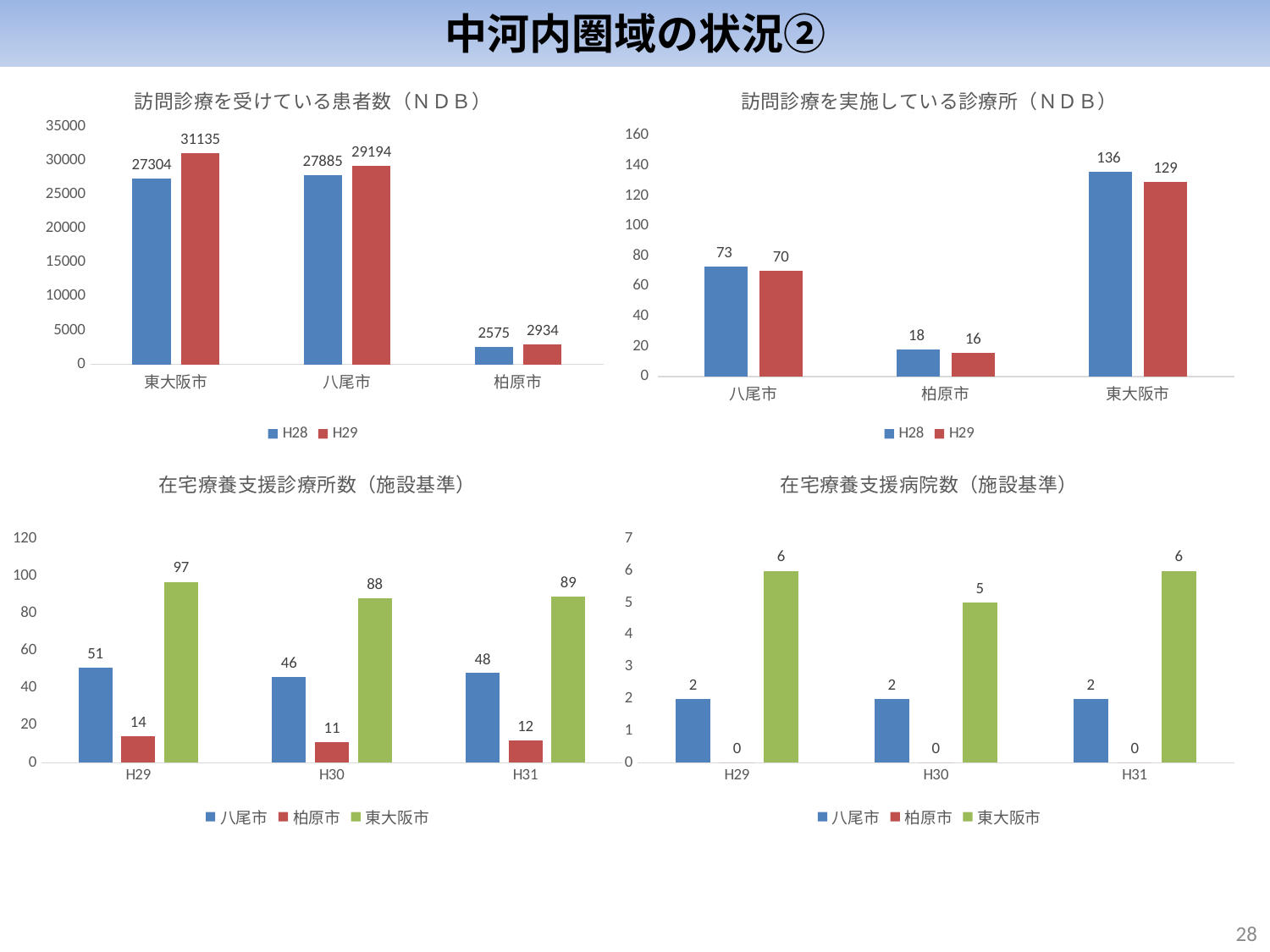
In the chart titled 訪問診療を受けている患者数（ＮＤＢ）, which category has the lowest H28 value? 柏原市 In the chart titled 訪問診療を受けている患者数（ＮＤＢ）, what is the difference between the H29 and H28 values for 八尾市? 1309 In the chart titled 在宅療養支援診療所数（施設基準）, what is the difference between 東大阪市 and 八尾市 in H29? 46 In the chart titled 在宅療養支援病院数（施設基準）, what is the value for 柏原市 in H31? 0 In the chart titled 訪問診療を実施している診療所（ＮＤＢ）, what is the H28 value for 東大阪市? 136 In the chart titled 在宅療養支援診療所数（施設基準）, what is the value for 東大阪市 in H30? 88 In the chart titled 在宅療養支援病院数（施設基準）, which series has the highest value in H30? 東大阪市 What kind of chart is the one titled 在宅療養支援病院数（施設基準）? bar chart In the chart titled 訪問診療を実施している診療所（ＮＤＢ）, which is larger for 八尾市, the H28 value or the H29 value? H28 In the chart titled 在宅療養支援診療所数（施設基準）, how many categories are shown on the x axis? 3 In the chart titled 訪問診療を受けている患者数（ＮＤＢ）, what is the H29 value for 東大阪市? 31135 In the chart titled 訪問診療を実施している診療所（ＮＤＢ）, how many series does the legend list? 2